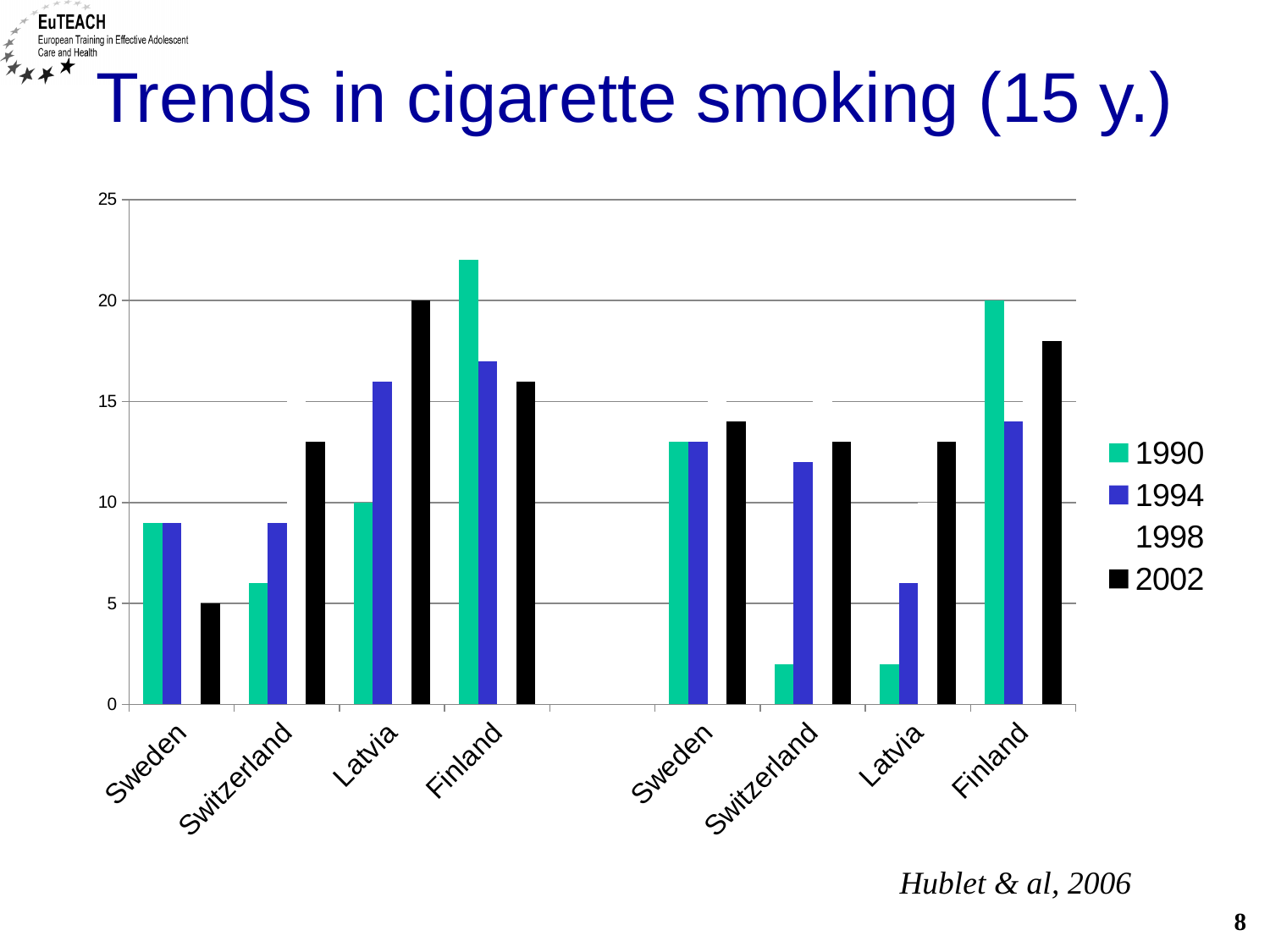
In the left group of countries, do the values for Switzerland rise or fall from 1990 to 2002? rise In the left group of countries, which is larger: the 1994 value for Latvia or the 1994 value for Switzerland? Latvia How many series does the legend list? 4 What colour represents the 2002 series in the legend? black In the left group of countries, what is the 2002 value for Latvia? 20 In the left group of countries, what is the 2002 value for Sweden? 5 What kind of chart is shown on the slide? bar chart How many country labels are shown along the x axis? 8 In the left group of countries, is the 1990 value for Finland greater or less than 20? greater In the right group of countries, is the 1990 value for Switzerland greater or less than 5? less In the left group of countries, which country has the highest 1990 value? Finland What is the title of the slide? Trends in cigarette smoking (15 y.)